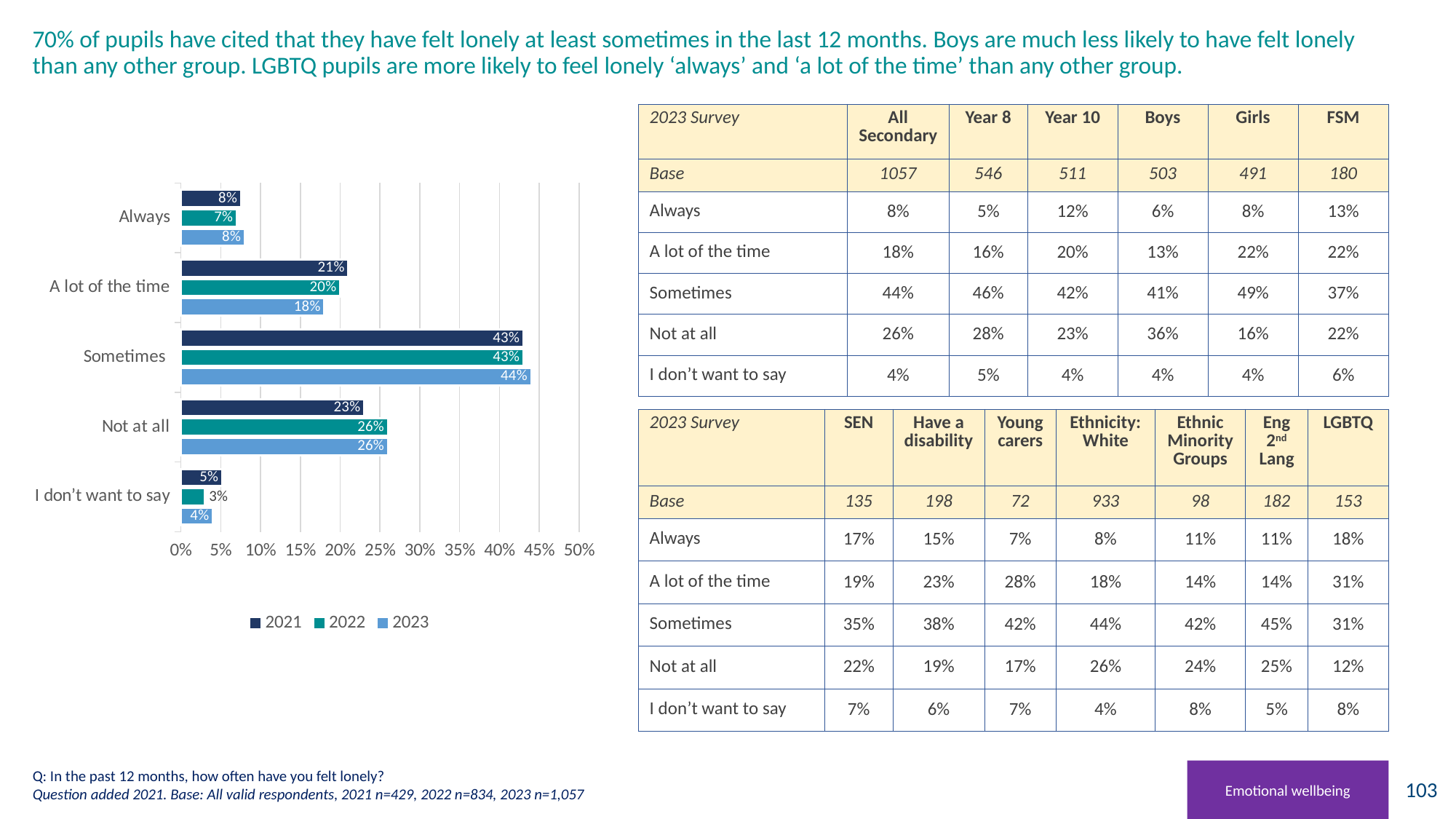
What is the difference between the 2021 and 2023 values for 'A lot of the time' in the chart? 3% What type of chart is shown on the slide? bar chart What is the 2023 value for 'Sometimes' in the chart? 44% Is the 2022 value for 'Sometimes' in the chart greater or less than 40%? greater How many series does the chart legend list? 3 How many categories are shown on the chart? 5 What is the 2021 value for 'A lot of the time' in the chart? 21% Which category has the highest 2023 value in the chart? Sometimes What is the 2022 value for 'I don't want to say' in the chart? 3% In the chart, is the 2021 value for 'Not at all' larger or smaller than the 2022 value for 'Not at all'? smaller Which series in the chart legend is shown in the darkest colour? 2021 Which category has the lowest 2021 value in the chart? I don't want to say